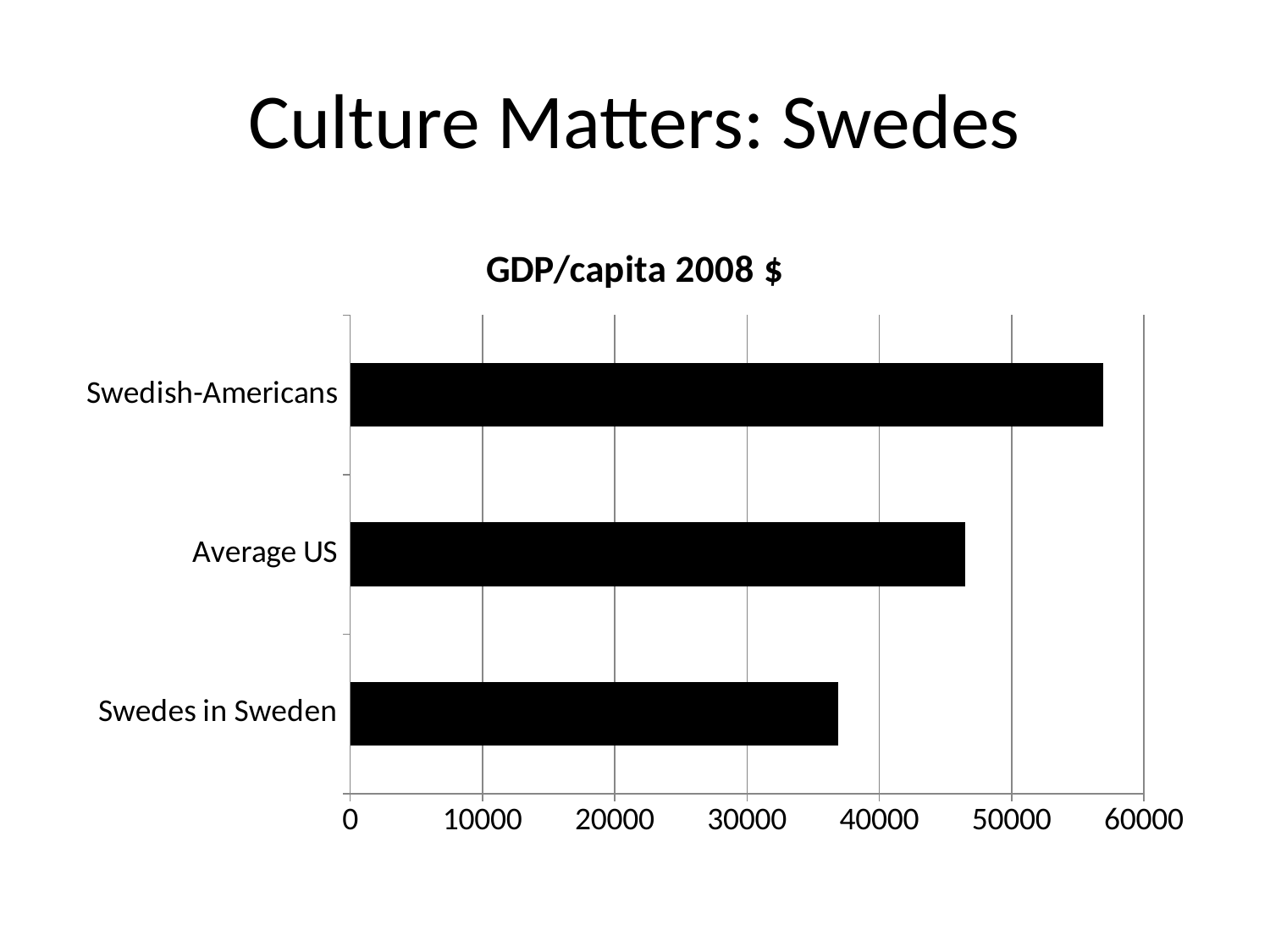
What kind of chart is shown on the slide? bar chart Which category has the lowest GDP/capita? Swedes in Sweden Which is larger, the value for Average US or the value for Swedes in Sweden? Average US Which category has the highest GDP/capita? Swedish-Americans Is the value for Average US greater or less than 40000? greater Is the value for Swedes in Sweden greater or less than 30000? greater Is the value for Swedes in Sweden greater or less than 40000? less Which is larger, the value for Swedish-Americans or the value for Average US? Swedish-Americans What is the maximum value shown on the horizontal axis? 60000 What is the title of the chart? GDP/capita 2008 $ How many categories are plotted in the chart? 3